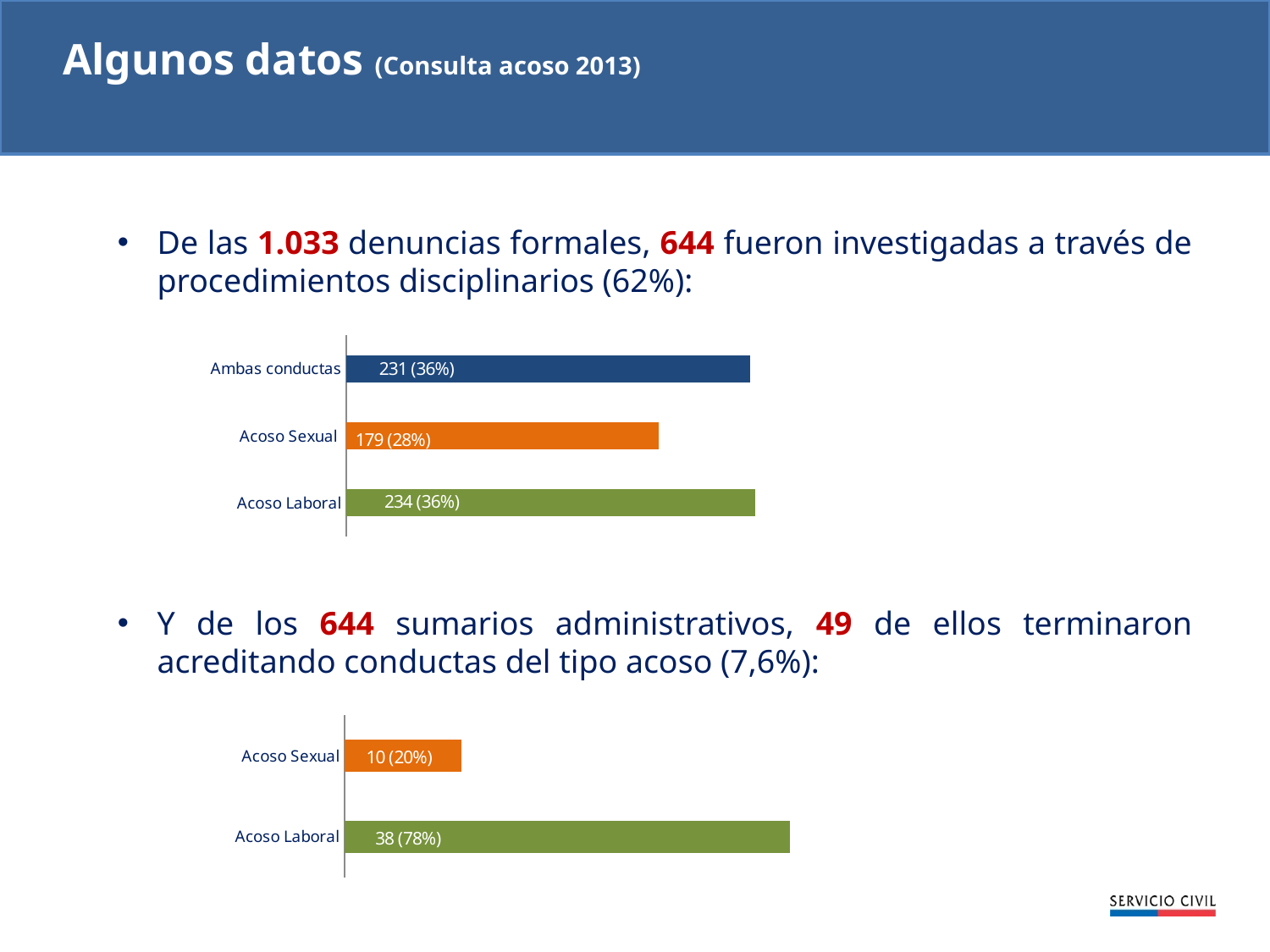
In the upper chart, what is the value shown for Ambas conductas? 231 (36%) In the lower chart, what is the difference between the counts for Acoso Laboral and Acoso Sexual? 28 In the lower chart, what is the value shown for Acoso Laboral? 38 (78%) In the upper chart, what is the value shown for Acoso Sexual? 179 (28%) In the lower chart, which category has the highest value? Acoso Laboral In the lower chart, what is the value shown for Acoso Sexual? 10 (20%) In the upper chart, what is the difference between the counts for Acoso Laboral and Acoso Sexual? 55 In the upper chart, what is the value shown for Acoso Laboral? 234 (36%) What type of chart is the upper chart? Bar chart In the lower chart, how many categories are shown? 2 In the upper chart, how many categories are shown? 3 In the upper chart, which category has the lowest value? Acoso Sexual